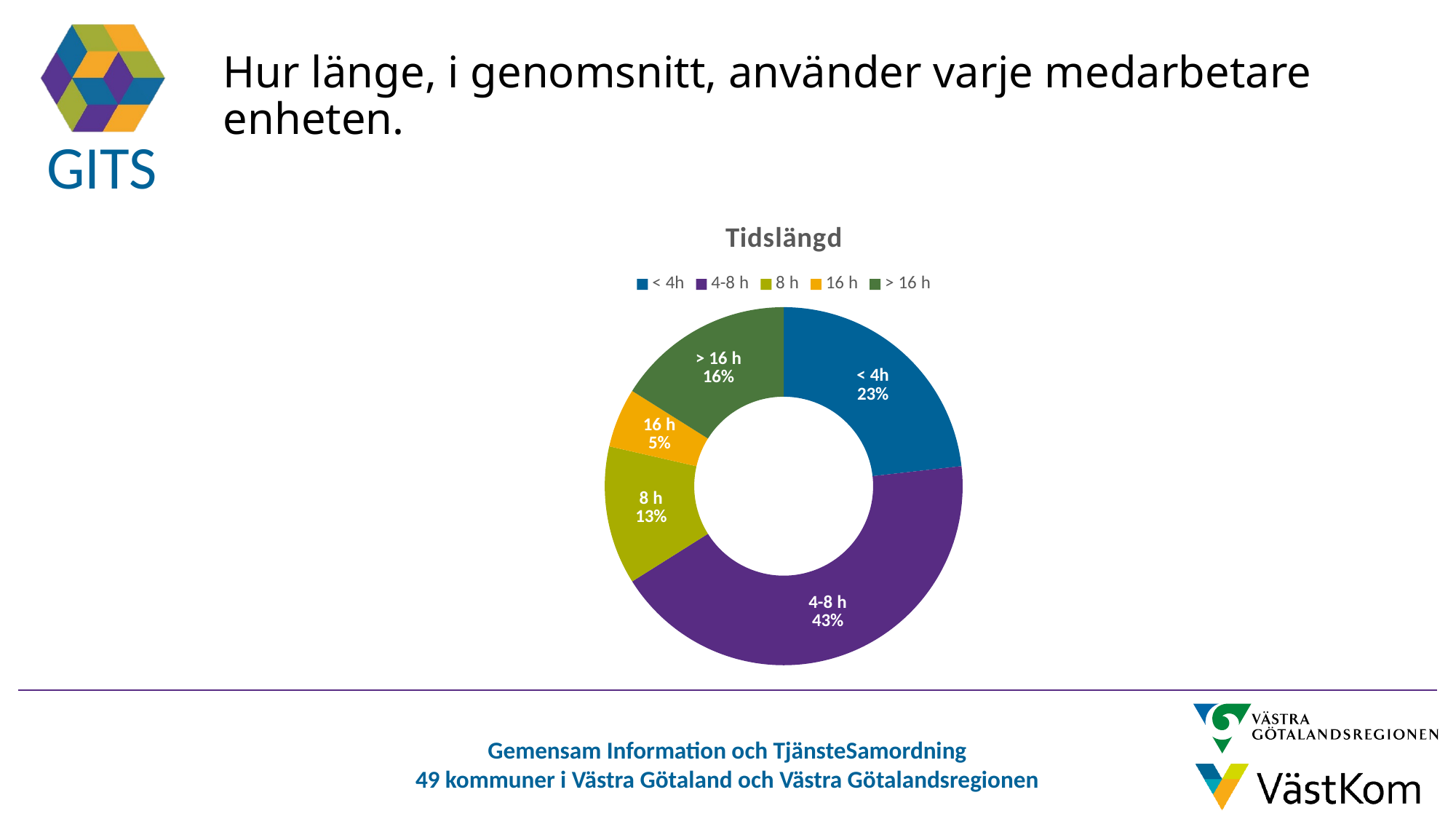
What type of chart is shown on the slide? Doughnut (pie) chart How many categories does the chart show? 5 What share of the chart does the '4-8 h' slice represent? 43% Which category has the largest share? 4-8 h What colour is the '4-8 h' slice? Purple What is the title of the chart? Tidslängd What is the value shown for the '< 4h' slice? 23% What is the value shown for the '> 16 h' slice? 16% Which is larger, the '8 h' slice or the '> 16 h' slice? > 16 h What is the difference in percentage points between the '4-8 h' and '< 4h' slices? 20 Which category has the smallest share? 16 h What is the value shown for the '16 h' slice? 5%